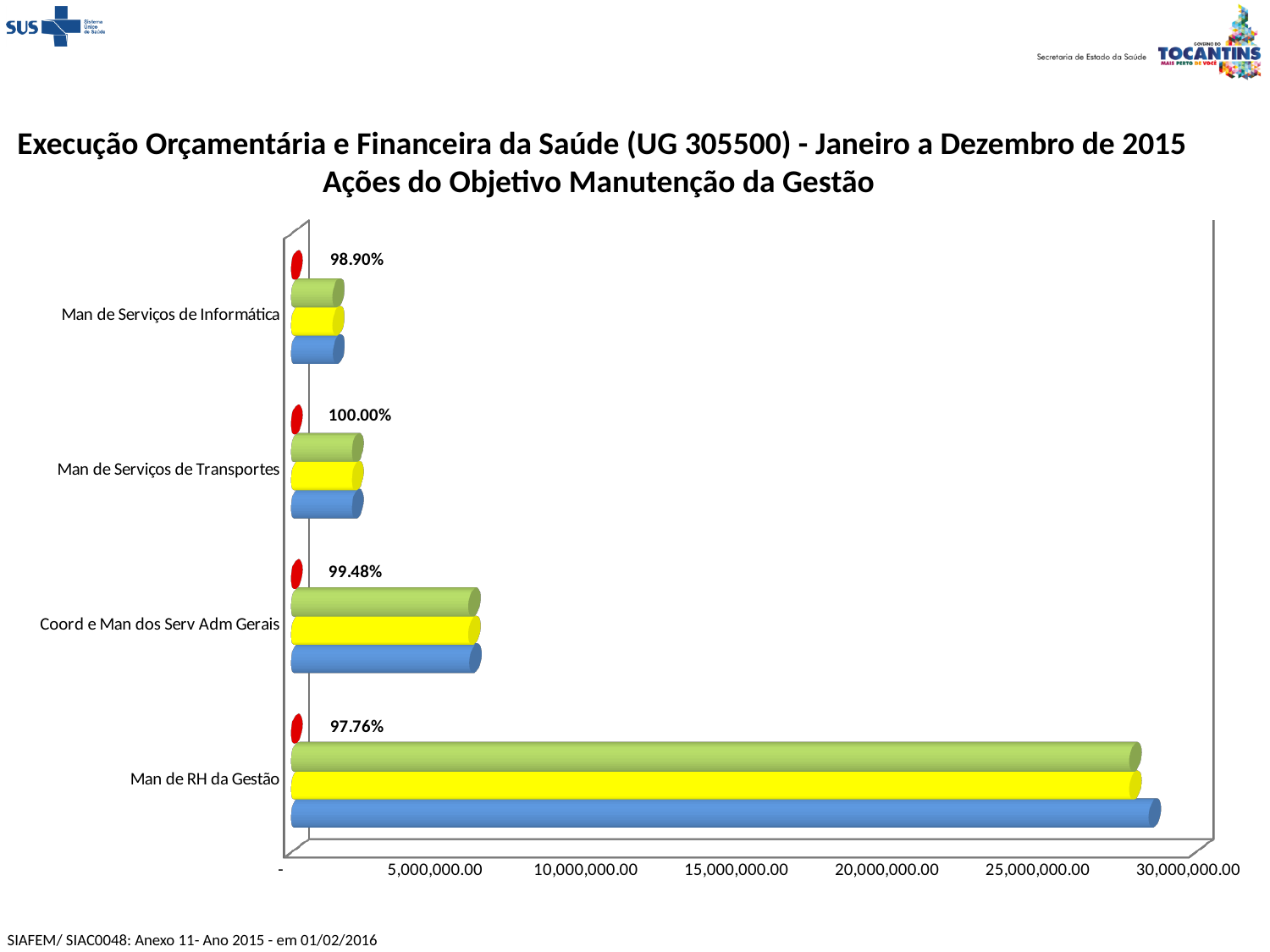
What percentage is labelled for Coord e Man dos Serv Adm Gerais? 99.48% Is the value of the blue bar for Man de RH da Gestão greater or less than 25,000,000.00? greater What percentage is labelled for Man de Serviços de Transportes? 100.00% Which category has the longest bars on the chart? Man de RH da Gestão Is the value of the blue bar for Man de Serviços de Informática greater or less than 5,000,000.00? less Which category has the highest percentage label? Man de Serviços de Transportes What is the difference between the percentage labels for Man de Serviços de Transportes and Man de RH da Gestão? 2.24% What percentage is labelled for Man de RH da Gestão? 97.76% What kind of chart is shown on the slide? bar chart What percentage is labelled for Man de Serviços de Informática? 98.90% How many categories are plotted on the chart? 4 Which category has the lowest percentage label? Man de RH da Gestão